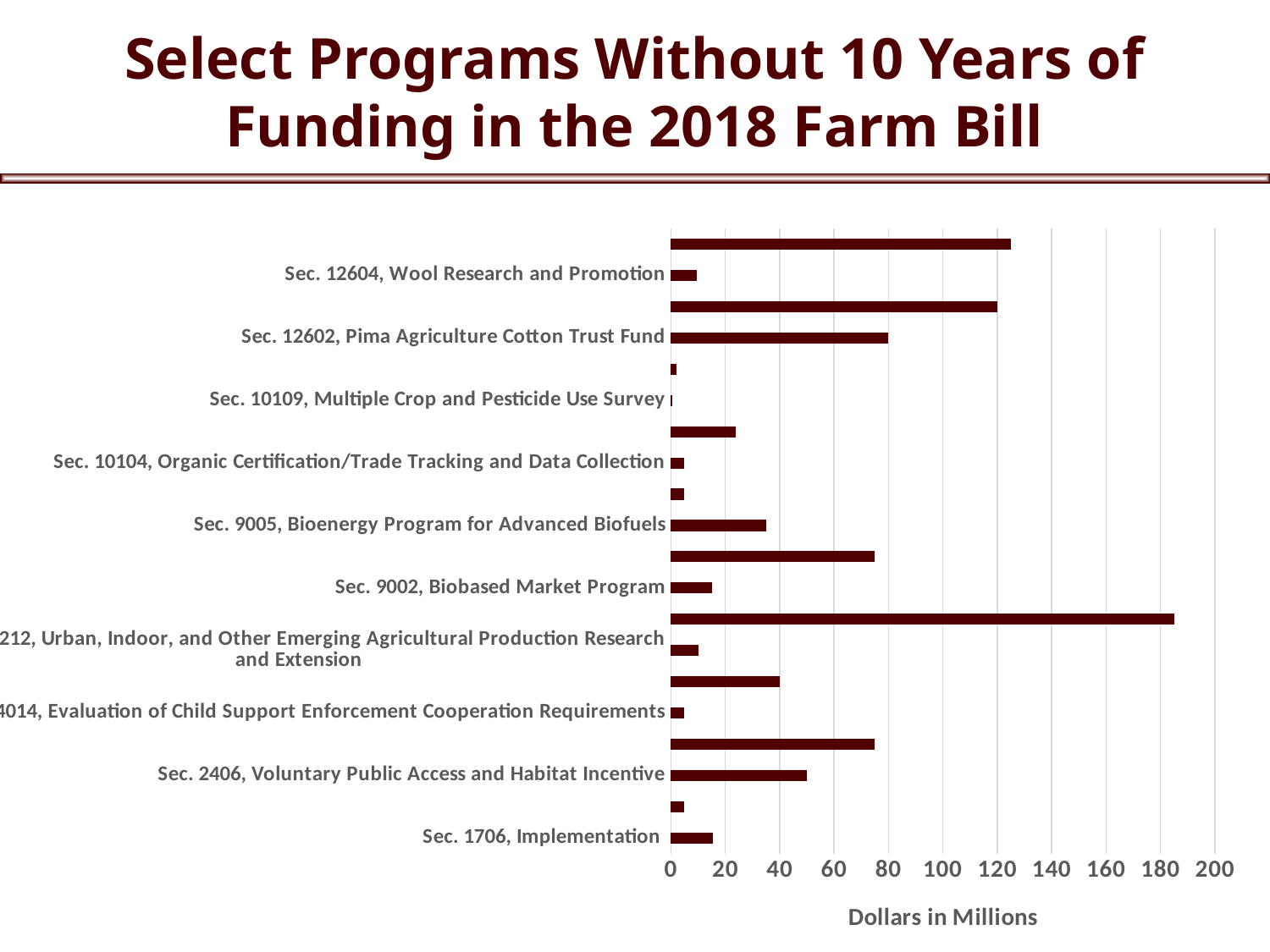
What is the title of the chart on the slide? Select Programs Without 10 Years of Funding in the 2018 Farm Bill Which has the larger value, Sec. 2406, Voluntary Public Access and Habitat Incentive or Sec. 9002, Biobased Market Program? Sec. 2406, Voluntary Public Access and Habitat Incentive Which has the larger value, Sec. 12602, Pima Agriculture Cotton Trust Fund or Sec. 2406, Voluntary Public Access and Habitat Incentive? Sec. 12602, Pima Agriculture Cotton Trust Fund Which has the larger value, Sec. 9005, Bioenergy Program for Advanced Biofuels or Sec. 12604, Wool Research and Promotion? Sec. 9005, Bioenergy Program for Advanced Biofuels Is the value for Sec. 12604, Wool Research and Promotion greater or less than 20? less What kind of chart is shown on the slide? Bar chart Is the value for Sec. 2406, Voluntary Public Access and Habitat Incentive greater or less than 40? greater Is the value for Sec. 9005, Bioenergy Program for Advanced Biofuels greater or less than 40? less What is the label on the horizontal axis of the chart? Dollars in Millions